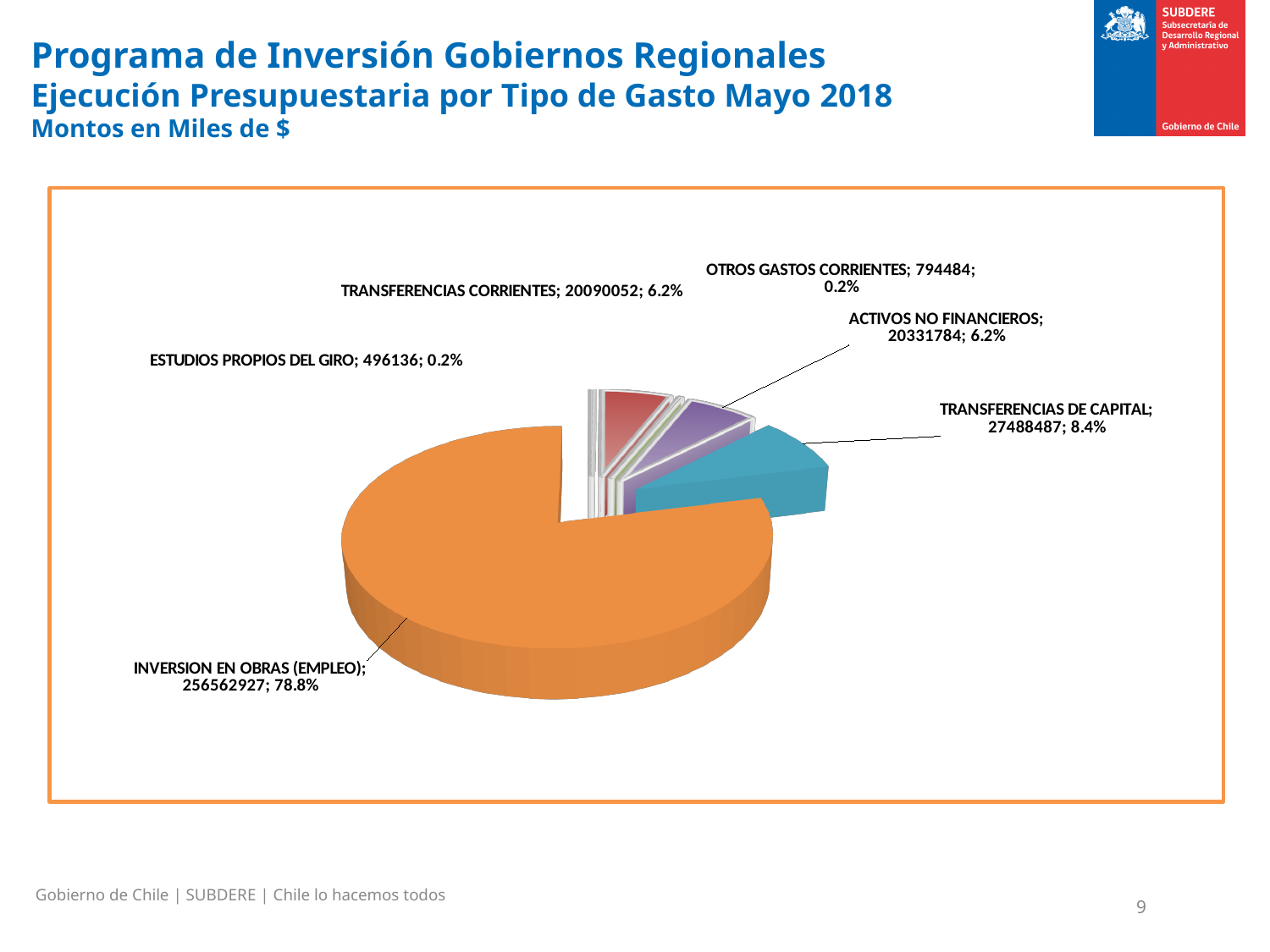
What is the value for TRANSFERENCIAS DE CAPITAL? 27488487 Which category has the smallest value? ESTUDIOS PROPIOS DEL GIRO What kind of chart is shown on the slide? Pie chart According to the slide subtitle, in what units are the amounts expressed? Miles de $ What share of the pie does TRANSFERENCIAS DE CAPITAL represent? 8.4% What is the value for OTROS GASTOS CORRIENTES? 794484 What share of the pie does INVERSION EN OBRAS (EMPLEO) represent? 78.8% What is the value for INVERSION EN OBRAS (EMPLEO)? 256562927 Which is larger, the value for OTROS GASTOS CORRIENTES or the value for ESTUDIOS PROPIOS DEL GIRO? OTROS GASTOS CORRIENTES How many categories (slices) does the pie chart show? 6 Which category has the largest value? INVERSION EN OBRAS (EMPLEO) What is the difference between the values for TRANSFERENCIAS DE CAPITAL and ACTIVOS NO FINANCIEROS? 7156703